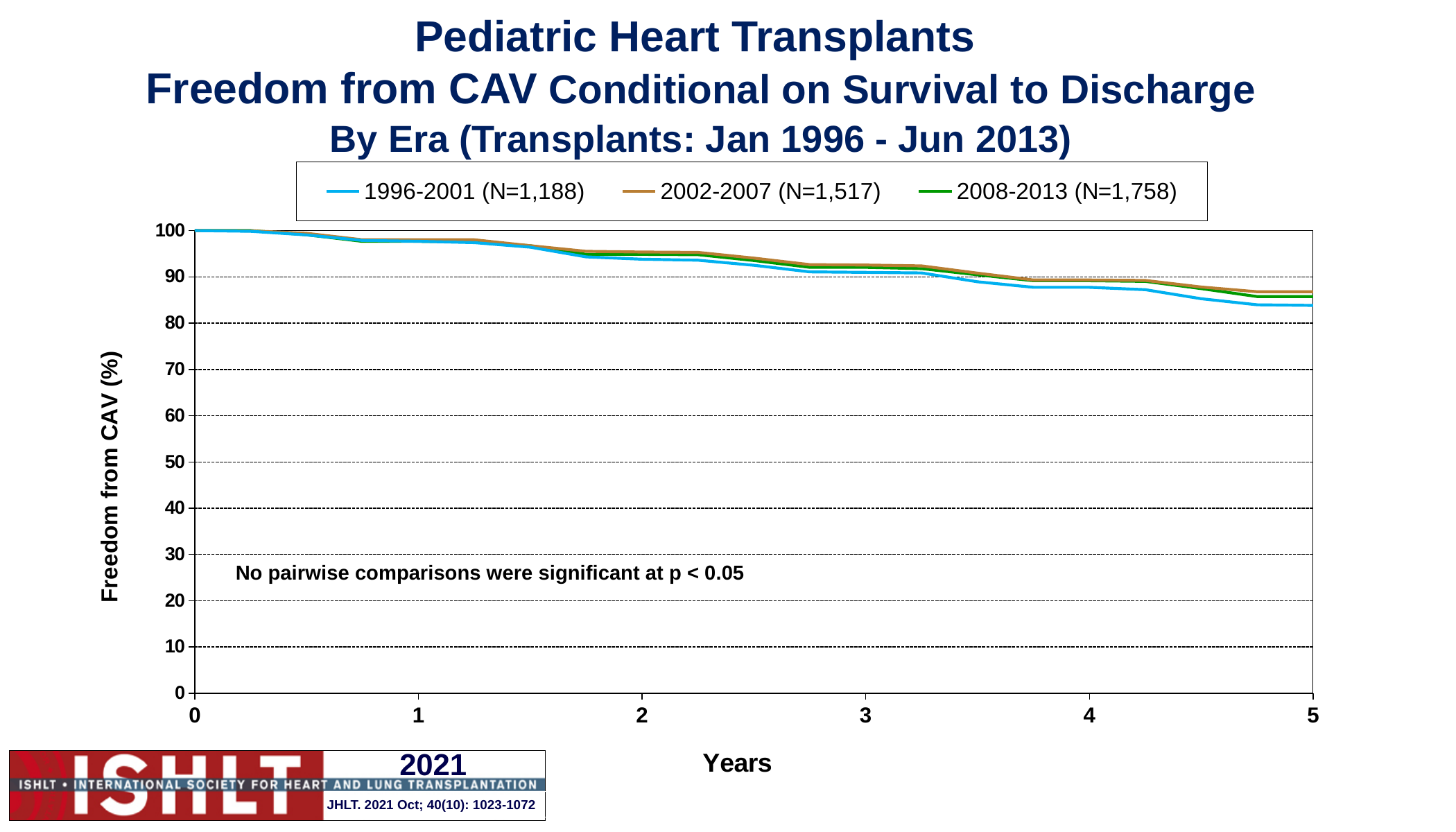
Is the value for the 1996-2001 (N=1,188) series at year 5 greater or less than 90? less At year 5, which series has the lowest freedom from CAV? 1996-2001 (N=1,188) What kind of chart is shown on the slide? line chart Is the value for the 1996-2001 (N=1,188) series at year 3 greater or less than 80? greater Do the values for the 1996-2001 series rise or fall as years increase? fall Is the value for the 2002-2007 (N=1,517) series at year 5 greater or less than 80? greater What is the label of the y axis? Freedom from CAV (%) What is the label of the x axis? Years How many series does the legend list? 3 At year 5, is the value for 2002-2007 (N=1,517) larger or smaller than the value for 1996-2001 (N=1,188)? larger What is the value for all three series at year 0? 100